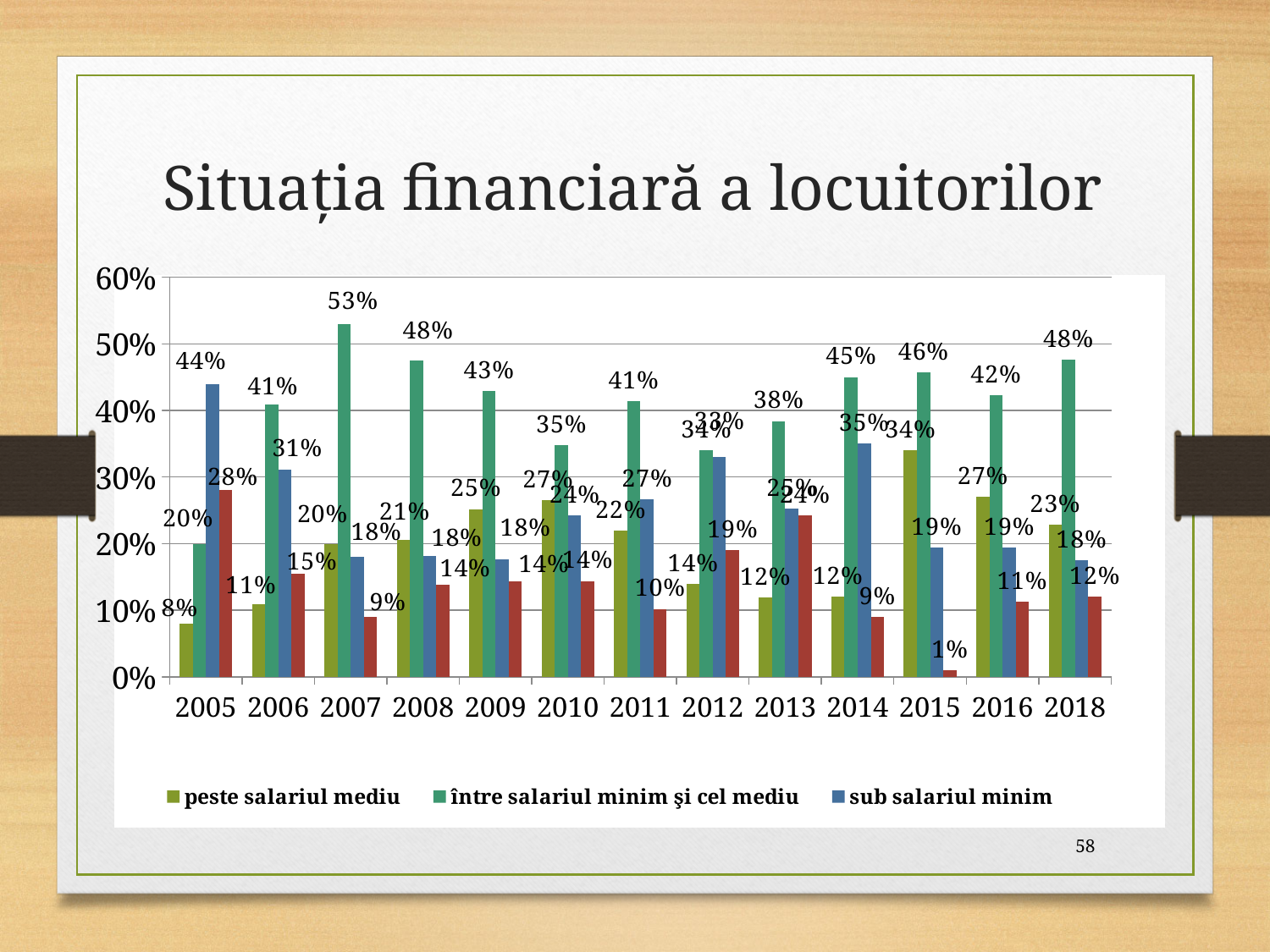
What is the difference between "între salariul minim și cel mediu" and "peste salariul mediu" in 2007? 33 percentage points In which year is the "peste salariul mediu" series lowest? 2005 How many series does the legend list? 3 Is the value for "între salariul minim și cel mediu" in 2008 greater or less than 40%? greater Which is larger: "sub salariul minim" in 2014 or "sub salariul minim" in 2015? 2014 What is the value for "sub salariul minim" in 2005? 44% What is the value for "peste salariul mediu" in 2015? 34% What is the value for "între salariul minim și cel mediu" in 2007? 53% How many years are shown on the x axis? 13 What kind of chart is shown on the slide? Bar chart Does the "peste salariul mediu" series rise or fall from 2005 to 2010? Rises In which year is the "între salariul minim și cel mediu" series highest? 2007